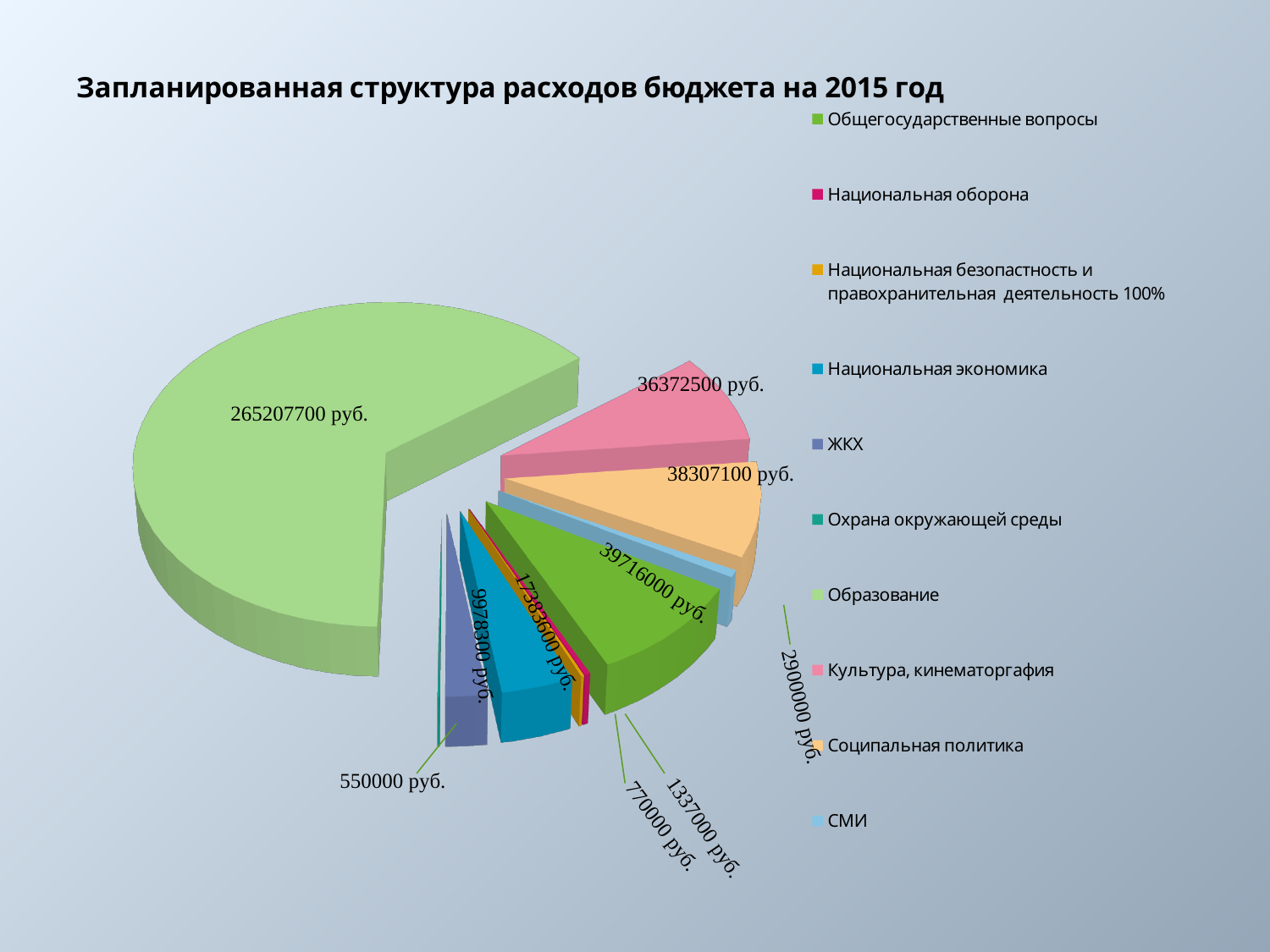
What is the smallest value labelled on the pie chart? 550000 руб. What is the difference between the value for Общегосударственные вопросы and the value for Социальная политика? 1408900 руб. What is the value labelled for Социальная политика? 38307100 руб. What is the title of the chart on the slide? Запланированная структура расходов бюджета на 2015 год What is the value labelled for Культура, кинематоргафия? 36372500 руб. Which category has the largest slice of the pie? Образование What kind of chart is shown on the slide? Pie chart Which is larger, the value for Социальная политика or the value for Культура, кинематоргафия? Социальная политика What is the value labelled for Общегосударственные вопросы? 39716000 руб. What is the value labelled for СМИ? 2900000 руб. How many categories does the legend of the pie chart list? 10 What is the value labelled for Образование? 265207700 руб.